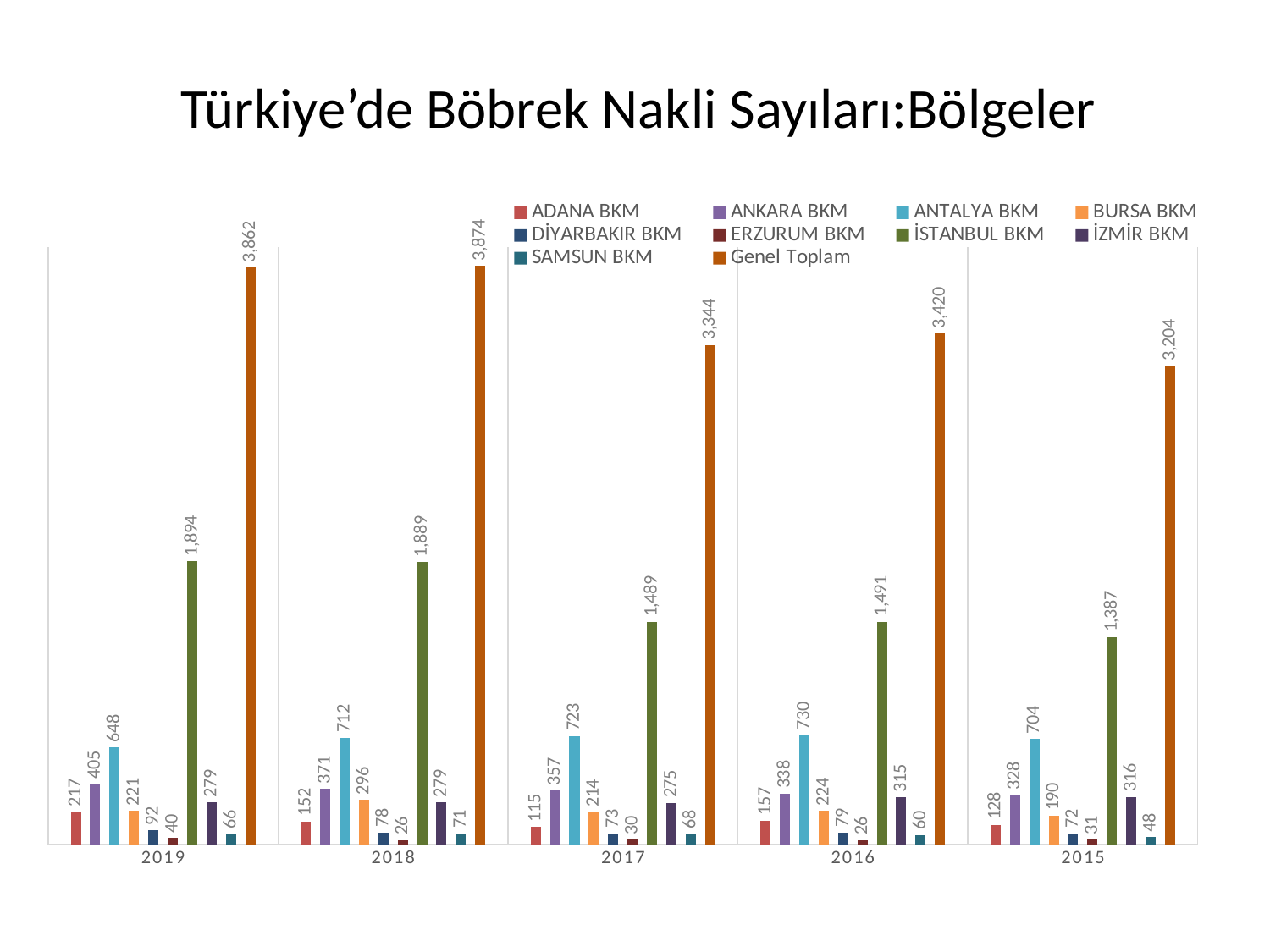
How many series does the legend list? 10 What is the value for İSTANBUL BKM in 2019? 1,894 What is the value for ANTALYA BKM in 2016? 730 How many years are shown on the x axis? 5 What is the Genel Toplam value for 2015? 3,204 What is the value for ERZURUM BKM in 2018? 26 Which region has the lowest value in 2017? ERZURUM BKM What kind of chart is shown on the slide? Bar chart In which year is the Genel Toplam value highest? 2018 Which is larger: ANKARA BKM in 2019 or ANKARA BKM in 2015? ANKARA BKM in 2019 What is the difference between the Genel Toplam values for 2019 and 2015? 658 What is the title of the chart on the slide? Türkiye'de Böbrek Nakli Sayıları:Bölgeler